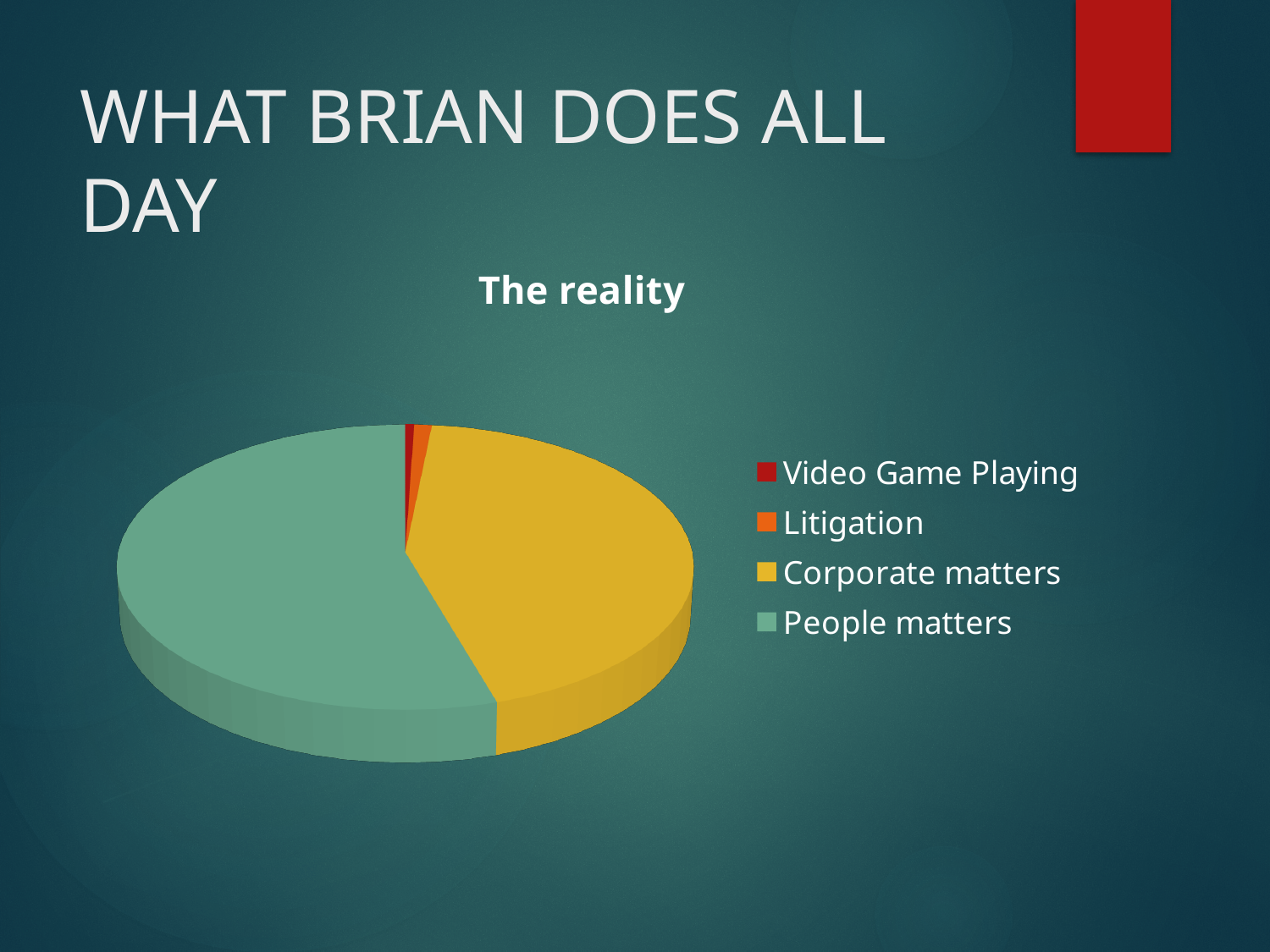
What is the title of the chart? The reality Which category has the largest slice of the pie? People matters Which category is shown in yellow in the pie chart? Corporate matters Which is larger, the slice for People matters or the slice for Video Game Playing? People matters What kind of chart is shown on the slide? Pie chart Which is larger, the slice for Corporate matters or the slice for Litigation? Corporate matters How many entries are listed in the chart's legend? 4 Which is larger, the slice for People matters or the slice for Corporate matters? People matters How many categories does the pie chart have? 4